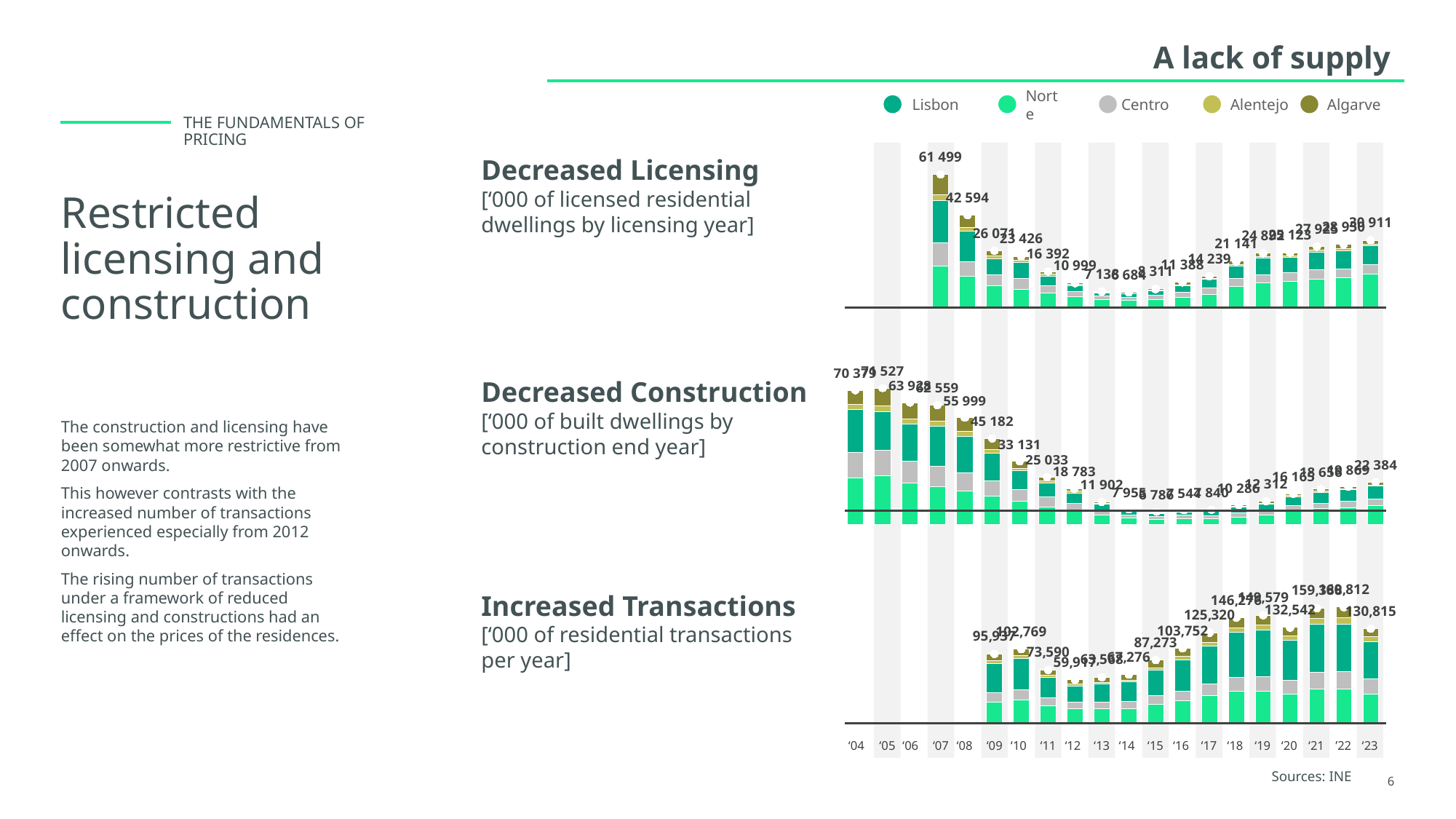
What kind of chart is the Decreased Construction chart? Stacked bar chart In the Decreased Construction chart, what is the total value labelled for '09? 45 182 In the Increased Transactions chart, what is the total value labelled for '17? 125,320 In the Decreased Construction chart, what is the total value labelled for '23? 22 384 How many series does the legend list for the charts? 5 In the Decreased Licensing chart, which year has the highest total? '07 In the Decreased Construction chart, what is the difference between the totals for '09 and '10? 12 051 In the Increased Transactions chart, which is larger, the total for '20 or the total for '23? '20 In the Decreased Licensing chart, what is the difference between the totals for '07 and '08? 18 905 In the Decreased Licensing chart, what is the total value labelled for '07? 61 499 In the Decreased Licensing chart, what is the total value labelled for '11? 16 392 In the Increased Transactions chart, how many years have bars plotted? 15